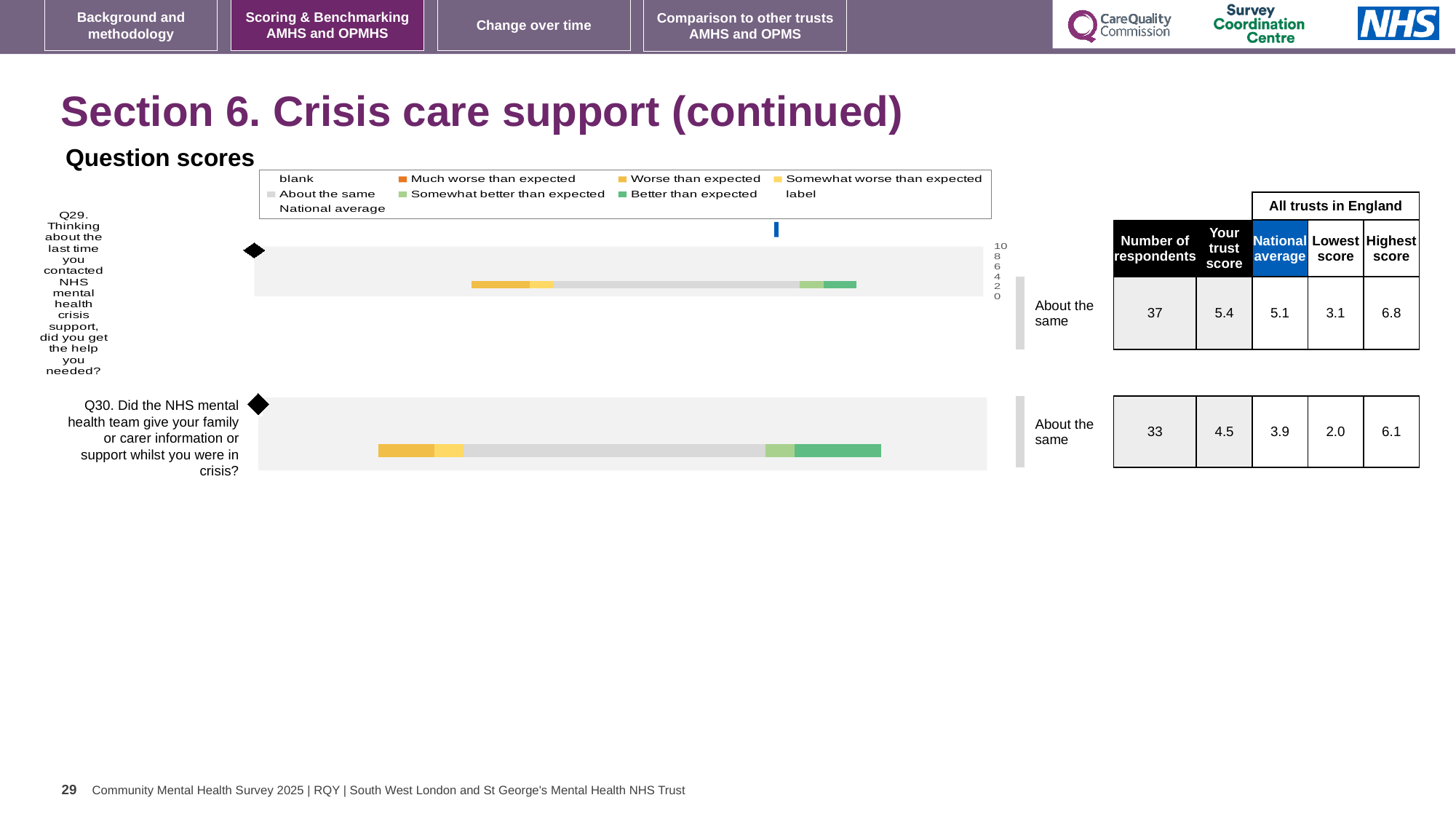
What benchmark category label is shown next to the bar for Q30? About the same What is the difference between the highest score and the lowest score for Q30? 4.1 What is the national average for Q30 in the question scores chart? 3.9 How many respondents answered Q29 in the question scores chart? 37 Which question has the higher trust score, Q29 or Q30? Q29 What is the trust score for Q29 in the question scores chart? 5.4 How many questions are plotted in the question scores chart? 2 What is the trust score for Q30 in the question scores chart? 4.5 What is the difference between the trust score and the national average for Q30? 0.6 Which is larger for Q29: the trust score or the national average? trust score What kind of chart is used to show the question scores on this slide? bar chart What is the highest score across all trusts in England for Q29? 6.8